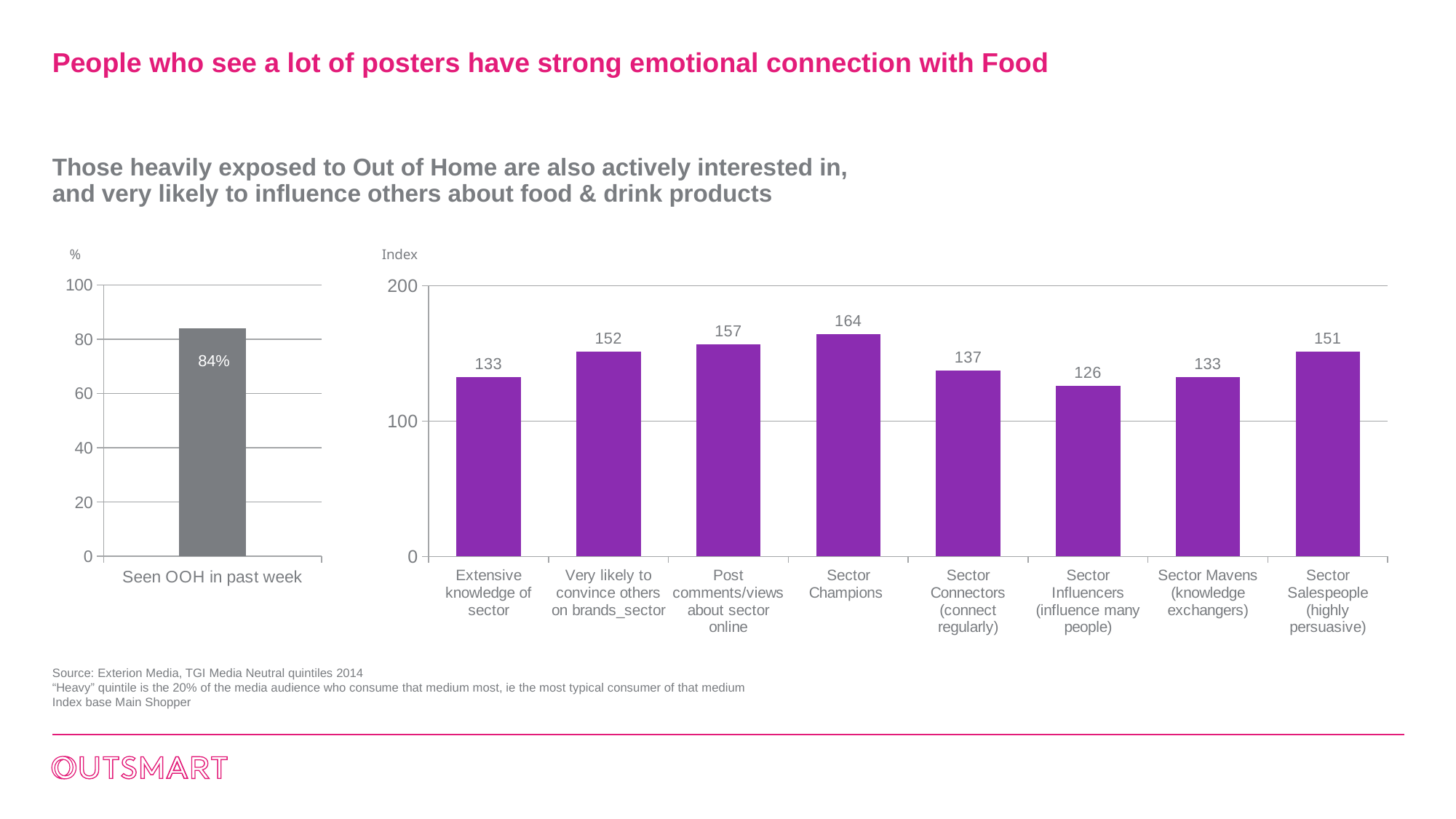
In the right chart (Index), which category has the lowest index value? Sector Influencers (influence many people) In the right chart (Index), what is the index value for Sector Champions? 164 In the right chart (Index), which category has the highest index value? Sector Champions In the right chart (Index), what is the index value for Sector Influencers (influence many people)? 126 In the left chart, what is the value for Seen OOH in past week? 84% In the right chart (Index), what is the difference between the index values for Sector Champions and Sector Influencers (influence many people)? 38 In the right chart (Index), is the value for Sector Salespeople (highly persuasive) greater or less than 100? greater What is the axis label shown above the y axis of the left chart? % In the right chart (Index), how many categories are shown on the x axis? 8 In the right chart (Index), what is the index value for Post comments/views about sector online? 157 In the right chart (Index), which is larger: the index for Very likely to convince others on brands_sector or the index for Sector Connectors (connect regularly)? Very likely to convince others on brands_sector What kind of chart is the right chart (Index)? Bar chart